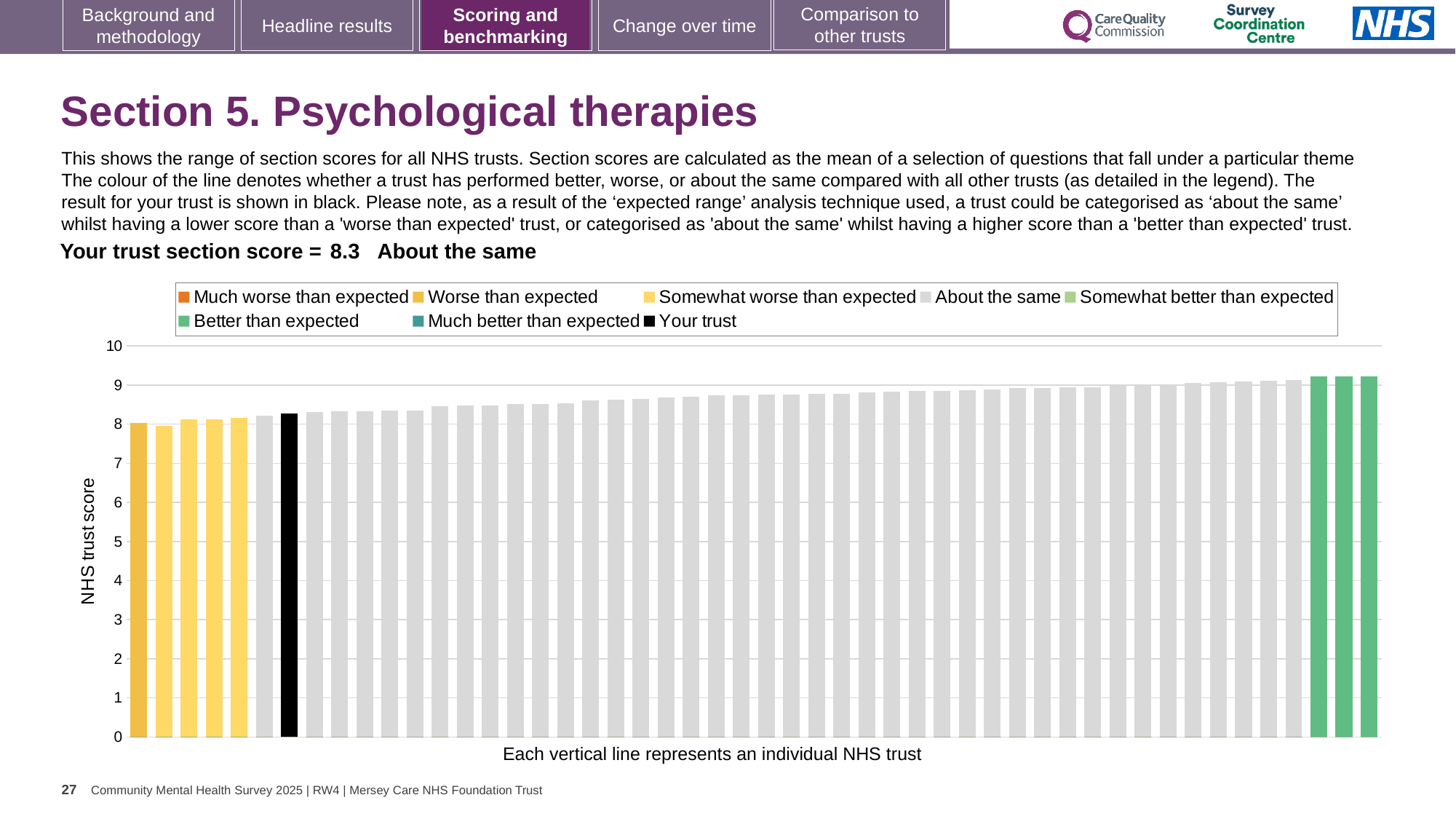
Is the value of the tallest bar greater or less than 9? greater What is the section score for your trust? 8.3 Do the bar values rise or fall from left to right along the x axis? rise What is the label on the vertical axis? NHS trust score How many bars are coloured as 'Much better than expected'? 0 Is the value for your trust greater or less than 8? greater What kind of chart is shown on the slide? bar chart Is the value of the shortest bar greater or less than 9? less Which legend category do the highest-scoring trusts belong to? Better than expected Which category is your trust's section score placed in? About the same How many bars are coloured as 'Better than expected'? 3 How many entries does the chart legend list? 8